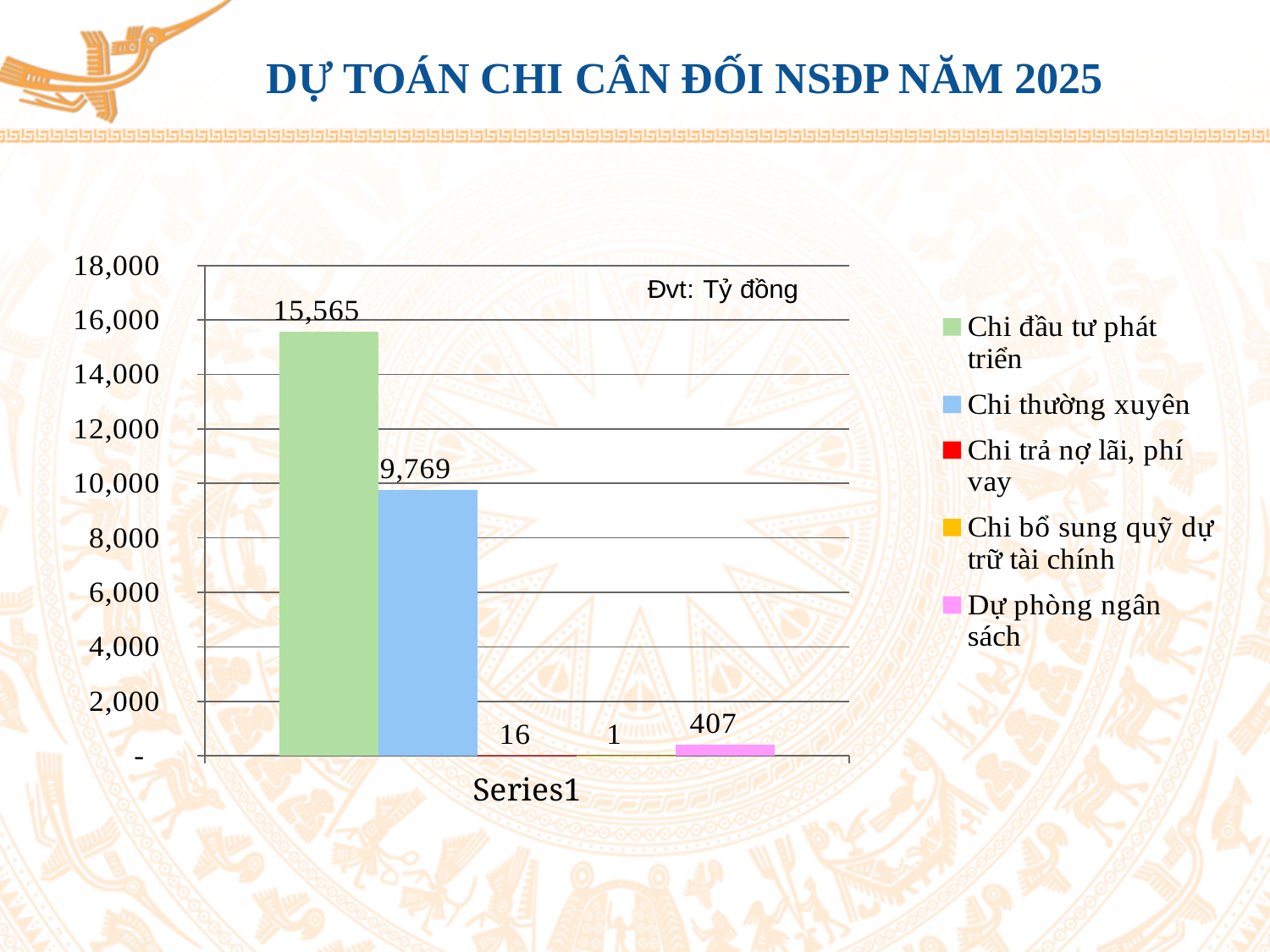
What kind of chart is shown on the slide? Bar chart What is the value for Chi thường xuyên? 9,769 What is the value for Chi trả nợ lãi, phí vay? 16 Which series has the lowest value? Chi bổ sung quỹ dự trữ tài chính How many series does the legend list? 5 What is the difference between Chi đầu tư phát triển and Chi thường xuyên? 5,796 Which is larger, Dự phòng ngân sách or Chi trả nợ lãi, phí vay? Dự phòng ngân sách Which series has the highest value? Chi đầu tư phát triển What is the value for Dự phòng ngân sách? 407 What is the value for Chi đầu tư phát triển? 15,565 What unit is stated on the chart? Tỷ đồng What is the title of the slide? DỰ TOÁN CHI CÂN ĐỐI NSĐP NĂM 2025